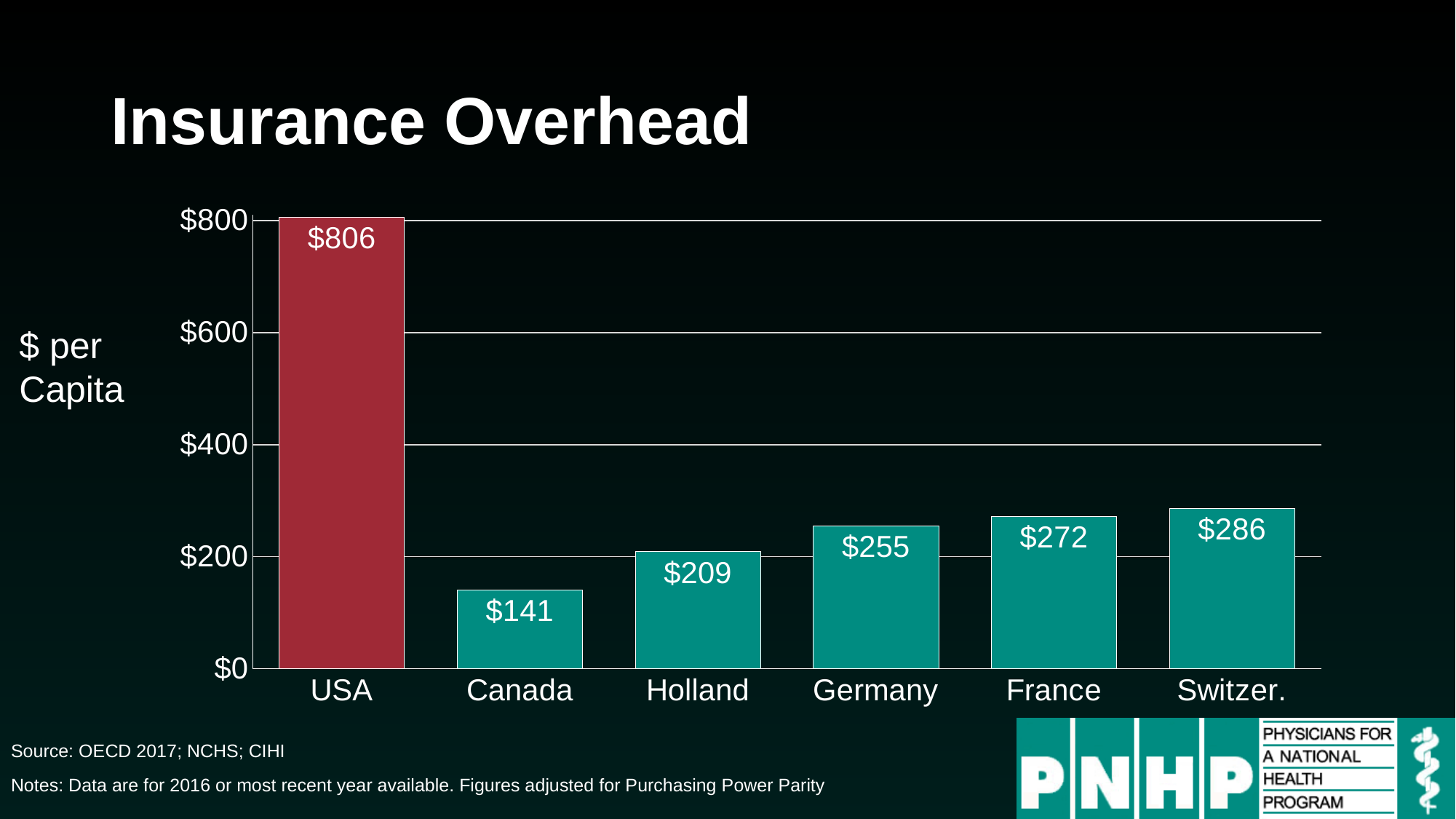
Is the value for France greater or less than $200? greater What is the insurance overhead per capita for the USA? $806 What is the difference in insurance overhead per capita between the USA and Canada? $665 What is the insurance overhead per capita for Canada? $141 What is the insurance overhead per capita for Germany? $255 What is the title of the chart? Insurance Overhead How many countries are shown in the chart? 6 Which has a higher insurance overhead per capita, Holland or Germany? Germany Which country has the highest insurance overhead per capita? USA What is the difference in insurance overhead per capita between Switzer. and France? $14 What kind of chart is shown on the slide? Bar chart Which country has the lowest insurance overhead per capita? Canada